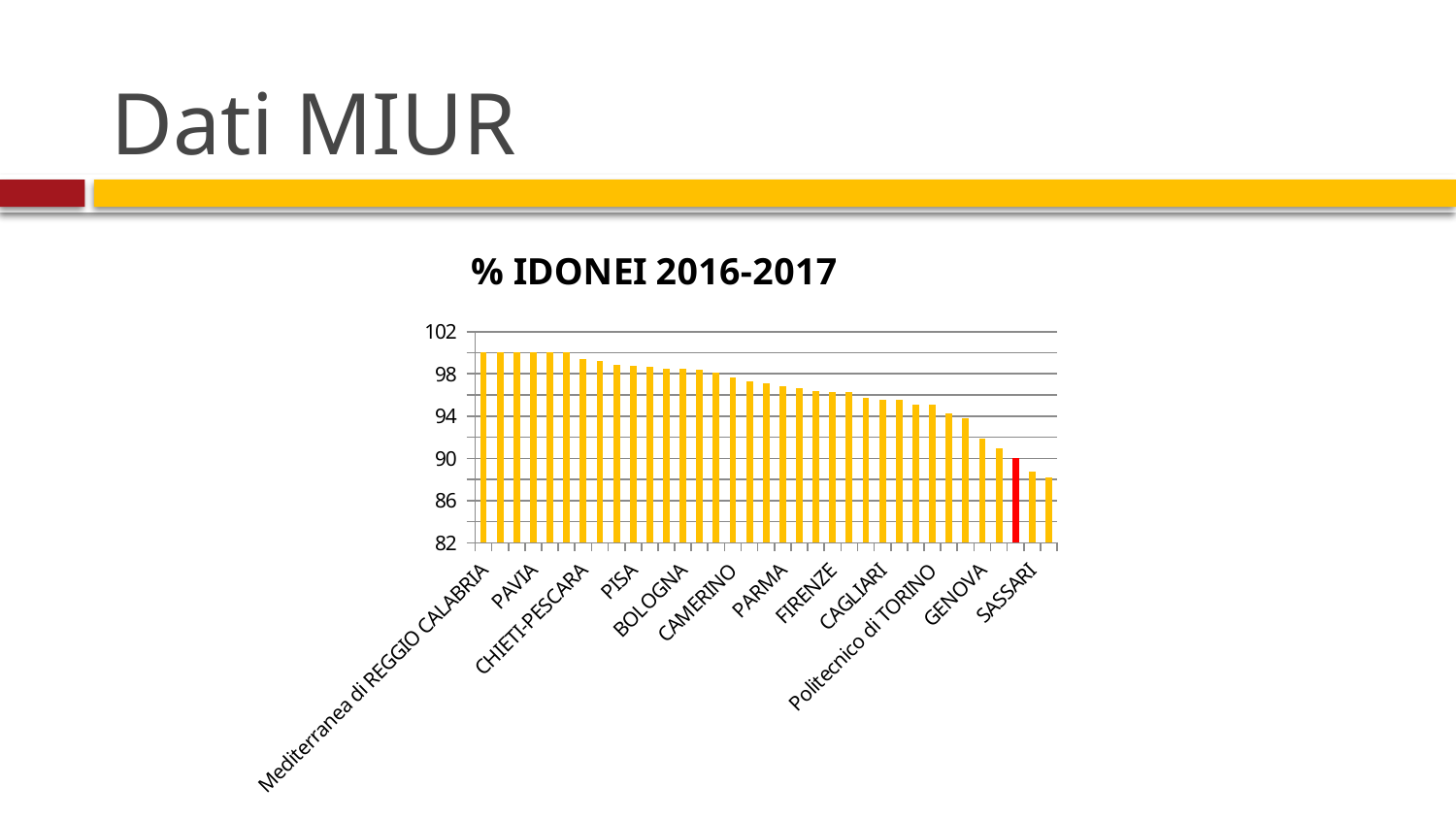
Is the value for Politecnico di TORINO greater or less than 94? greater Do the values rise or fall moving from left to right along the x axis? fall Is the value for PAVIA greater or less than 98? greater Which has the larger value, Mediterranea di REGGIO CALABRIA or SASSARI? Mediterranea di REGGIO CALABRIA Is the value for FIRENZE greater or less than 98? less What is the title of the chart? % IDONEI 2016-2017 What kind of chart is shown on the slide? bar chart What colour is the single highlighted bar near the right end of the chart? red Which has the larger value, PAVIA or GENOVA? PAVIA